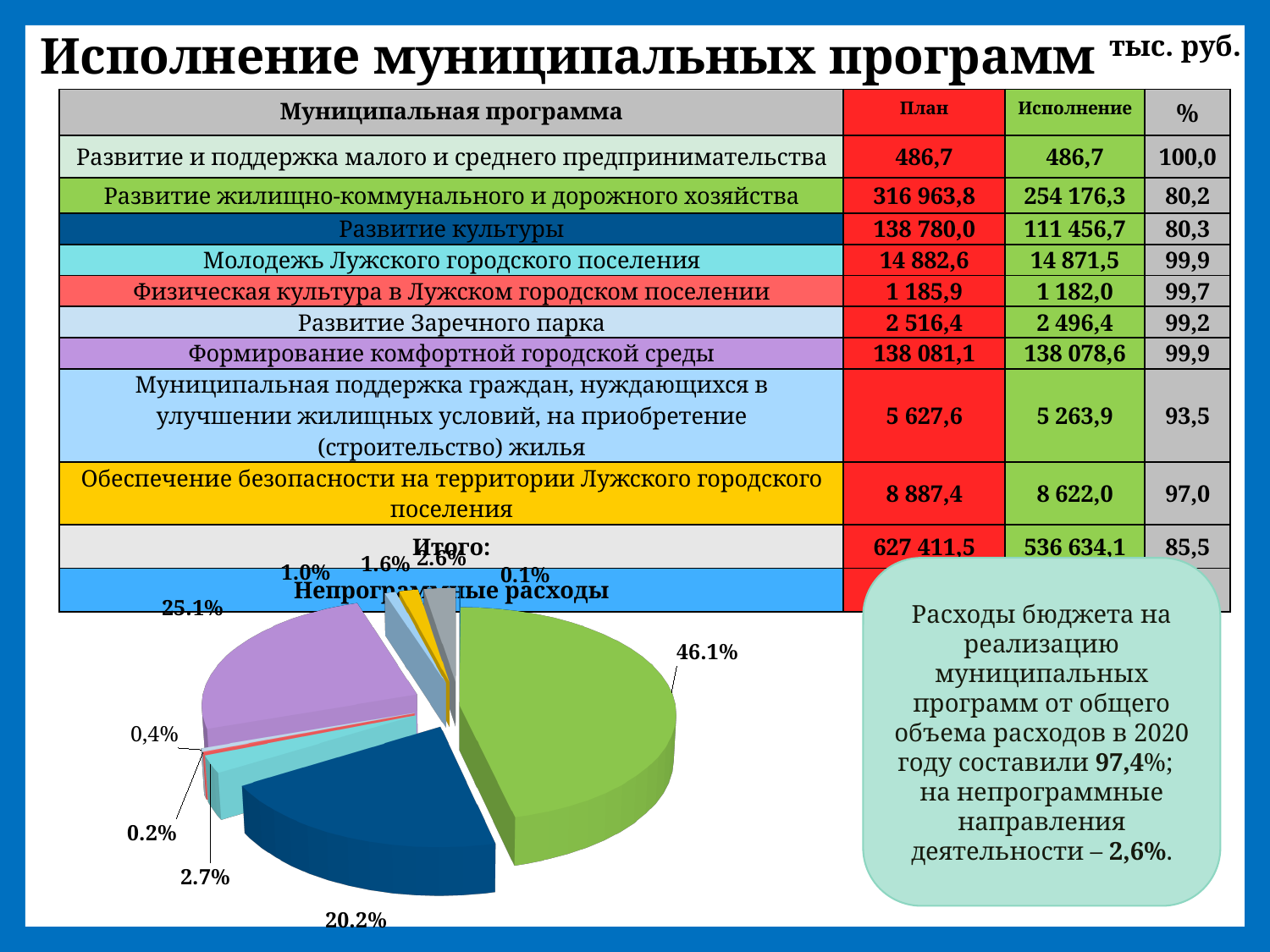
What share is labelled on the purple slice of the pie chart? 25.1% What kind of chart is shown at the bottom left of the slide? pie chart Does the pie chart display a legend? No What is the difference in percentage points between the largest slice (46.1%) and the purple slice (25.1%) on the pie chart? 21.0 What colour is the largest slice of the pie chart? green What is the largest share shown on the pie chart? 46.1% Is the share of the green slice on the pie chart greater or less than 40%? greater How many percentage labels are shown on the pie chart? 10 What share is labelled on the dark blue slice of the pie chart? 20.2% What is the smallest share labelled on the pie chart? 0.1% What share is labelled on the green slice of the pie chart? 46.1% On the pie chart, which slice is larger: the purple slice (25.1%) or the dark blue slice (20.2%)? the purple slice (25.1%)